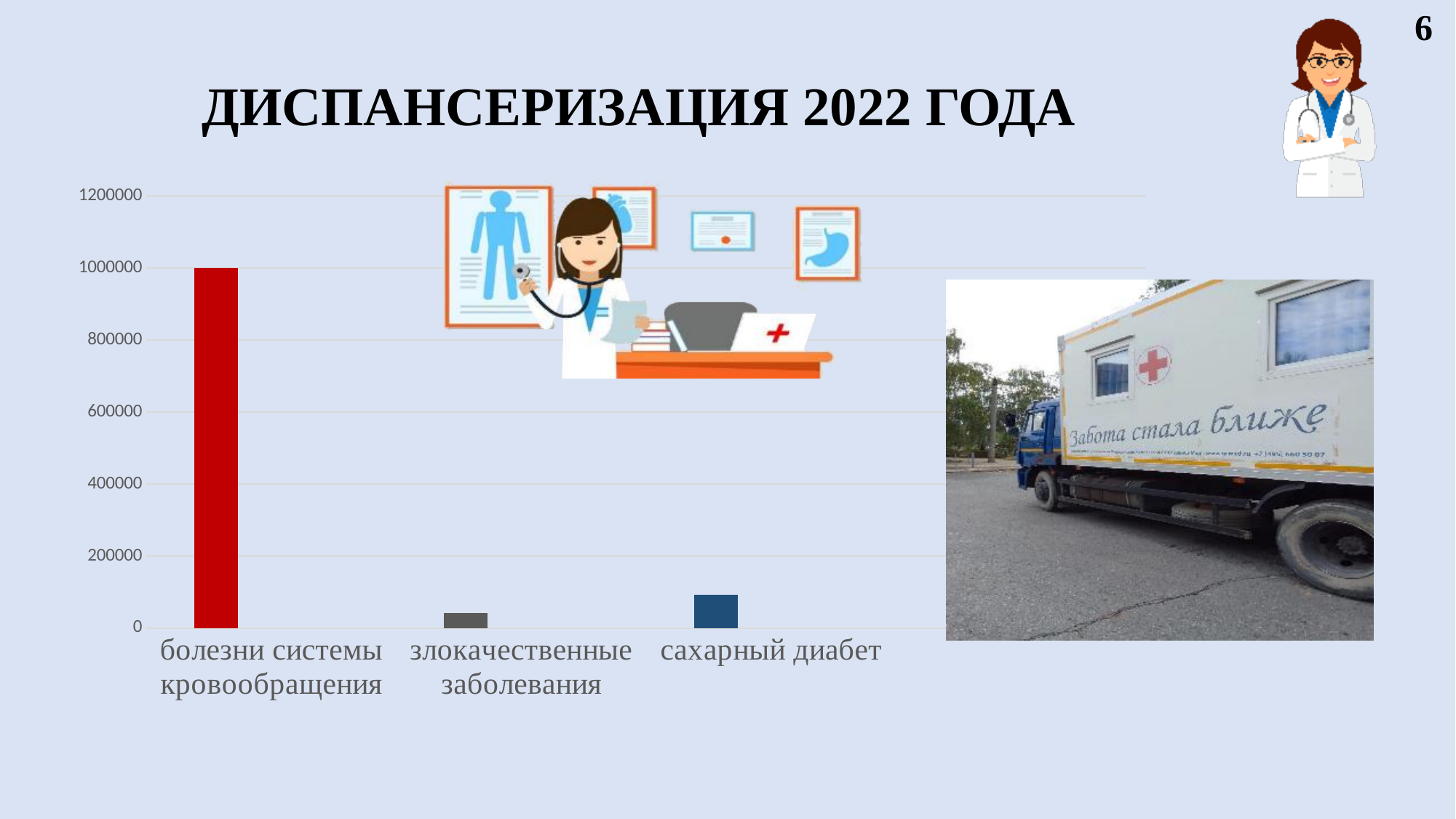
Which is larger: the value for болезни системы кровообращения or the value for сахарный диабет? болезни системы кровообращения How many categories are plotted in the chart? 3 Is the value for болезни системы кровообращения greater or less than 800000? greater What is the title of the slide containing the chart? ДИСПАНСЕРИЗАЦИЯ 2022 ГОДА What is the value for болезни системы кровообращения? 1000000 What kind of chart is shown on the slide? bar chart Which category has the lowest value in the chart? злокачественные заболевания Which is larger: the value for сахарный диабет or the value for злокачественные заболевания? сахарный диабет Is the value for злокачественные заболевания greater or less than 200000? less Is the value for сахарный диабет greater or less than 200000? less What colour is the bar for болезни системы кровообращения? red Which category has the highest value in the chart? болезни системы кровообращения